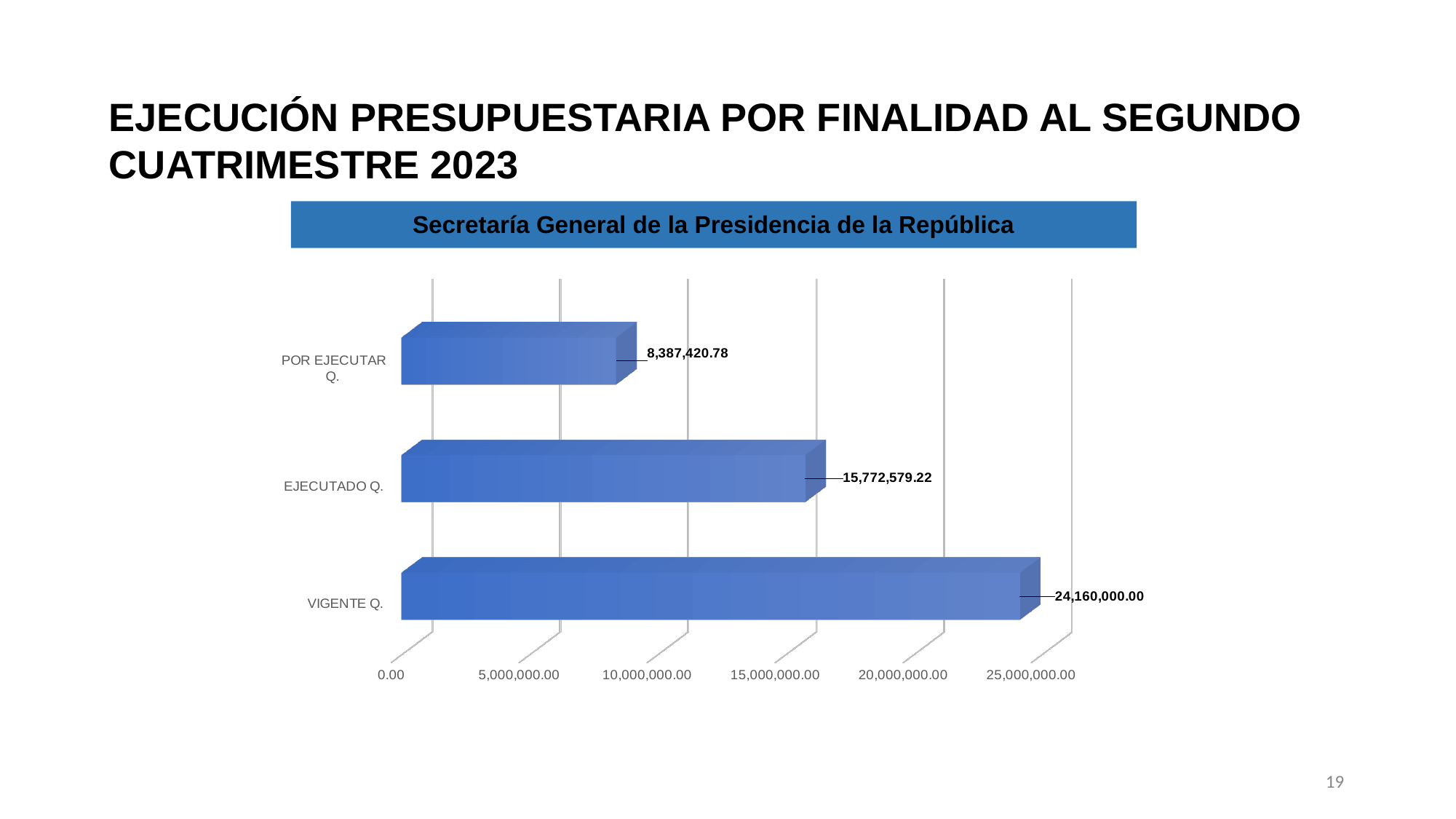
Is the value for EJECUTADO Q. greater or less than 15,000,000.00? greater Which category has the highest value? VIGENTE Q. What is the difference between VIGENTE Q. and EJECUTADO Q.? 8,387,420.78 What is the value for EJECUTADO Q.? 15,772,579.22 Which category has the lowest value? POR EJECUTAR Q. What is the value for VIGENTE Q.? 24,160,000.00 What is the difference between EJECUTADO Q. and POR EJECUTAR Q.? 7,385,158.44 How many categories are shown in the chart? 3 What kind of chart is shown on the slide? Bar chart What is the title of the chart? Secretaría General de la Presidencia de la República What is the value for POR EJECUTAR Q.? 8,387,420.78 Which is larger, EJECUTADO Q. or POR EJECUTAR Q.? EJECUTADO Q.